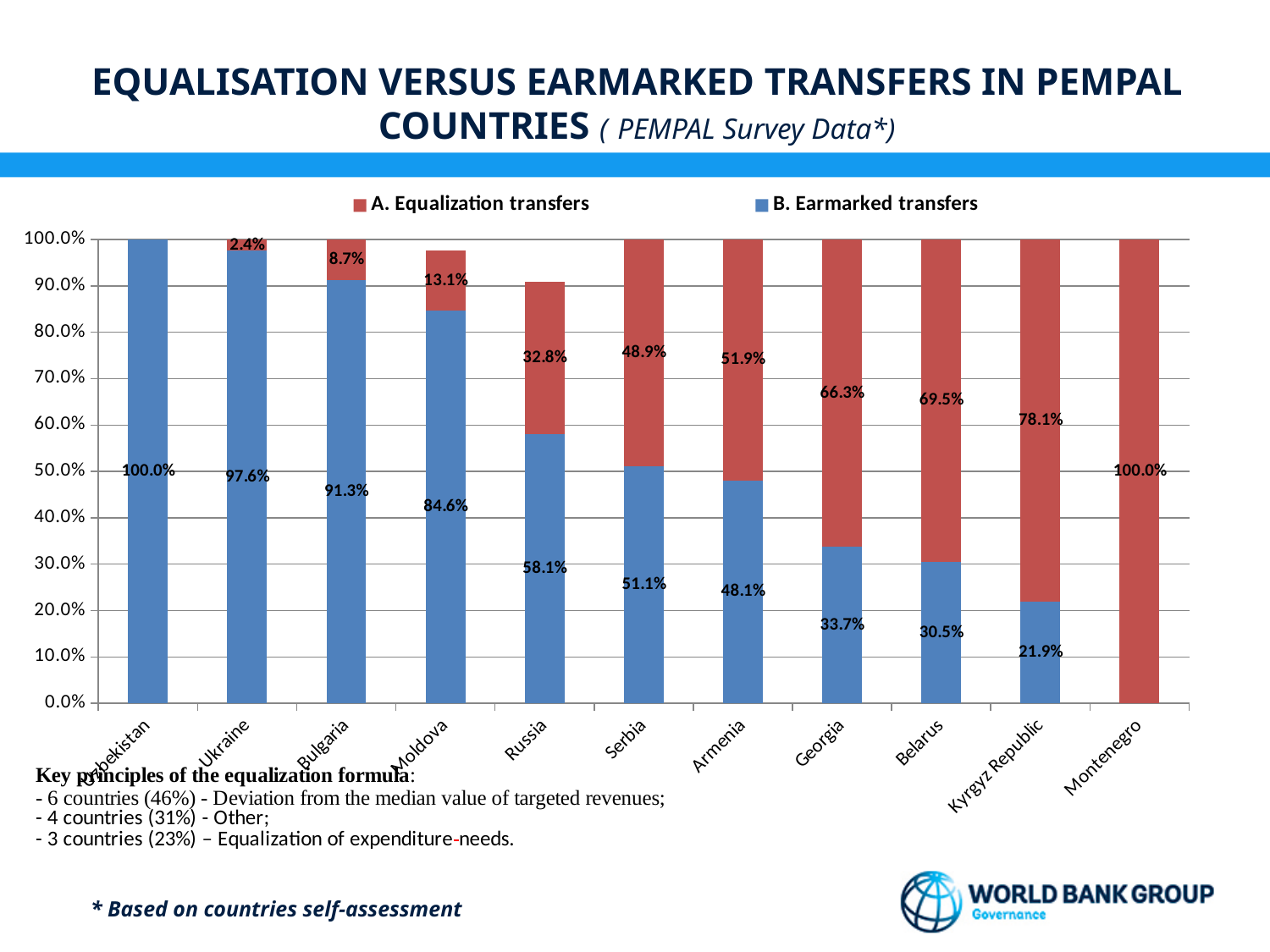
Is the value of B. Earmarked transfers for Moldova greater or less than 80.0%? greater For Russia, what is the difference between B. Earmarked transfers and A. Equalization transfers? 25.3 percentage points What is the value of A. Equalization transfers for Belarus? 69.5% What kind of chart is shown on the slide? Stacked bar chart What is the total of the stacked bar for Russia? 90.9% Which country has the highest share of A. Equalization transfers? Montenegro What is the value of B. Earmarked transfers for Georgia? 33.7% Among the countries with a labelled value for A. Equalization transfers, which has the lowest? Ukraine For Serbia, which is larger: A. Equalization transfers or B. Earmarked transfers? B. Earmarked transfers What is the value of A. Equalization transfers for Kyrgyz Republic? 78.1% How many series does the legend list? 2 How many countries are shown on the x axis of the chart? 11